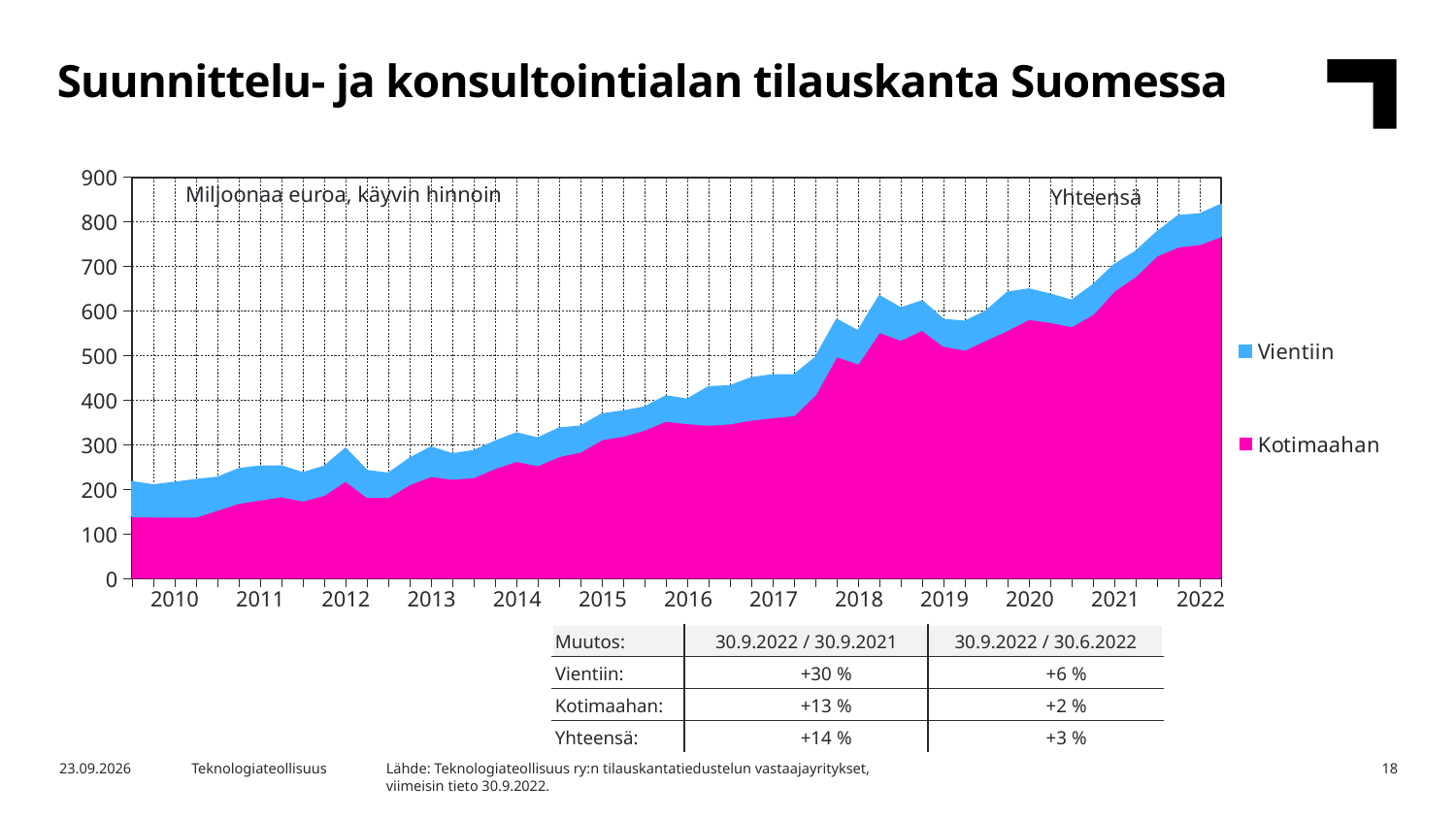
Is the total order backlog at the start of 2010 greater or less than 300? less Which two series are listed in the chart legend? Vientiin and Kotimaahan What kind of chart is shown on the slide? Stacked area chart How many years are labelled on the x axis of the chart? 13 Does the total order backlog (Yhteensä) generally rise or fall from 2010 to 2022? Rise In which year is the total order backlog at its lowest level? 2010 Is the total order backlog at the end of 2022 greater or less than 800? greater Is the Kotimaahan value at the end of 2022 greater or less than 700? greater What unit is stated in the label at the top left of the chart area? Miljoonaa euroa, käyvin hinnoin Which series is larger throughout the chart, Vientiin or Kotimaahan? Kotimaahan How many series does the chart legend list? 2 In which year does the total order backlog reach its highest level? 2022